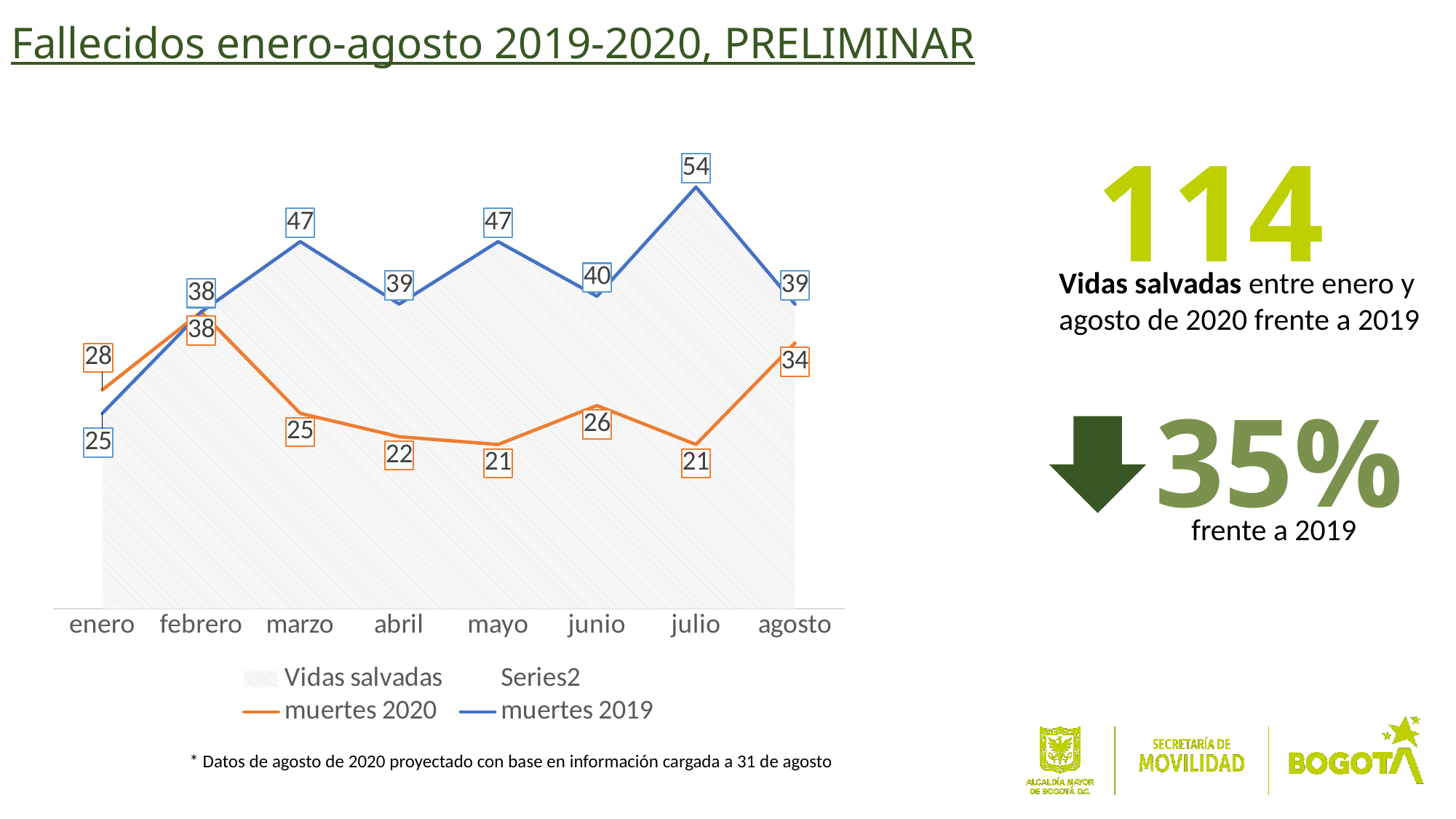
What kind of chart is shown on the slide? a combination area and line chart What is the difference between muertes 2019 and muertes 2020 in julio? 33 What is the value for muertes 2019 in julio? 54 What is the value for muertes 2020 in agosto? 34 In which month is muertes 2019 lowest? enero What is the value for muertes 2020 in abril? 22 In enero, which is larger: muertes 2020 or muertes 2019? muertes 2020 What is the title of the slide? Fallecidos enero-agosto 2019-2020, PRELIMINAR In which month is muertes 2020 highest? febrero How many months are shown on the x axis? 8 In which month is muertes 2019 highest? julio How many entries does the legend list? 4